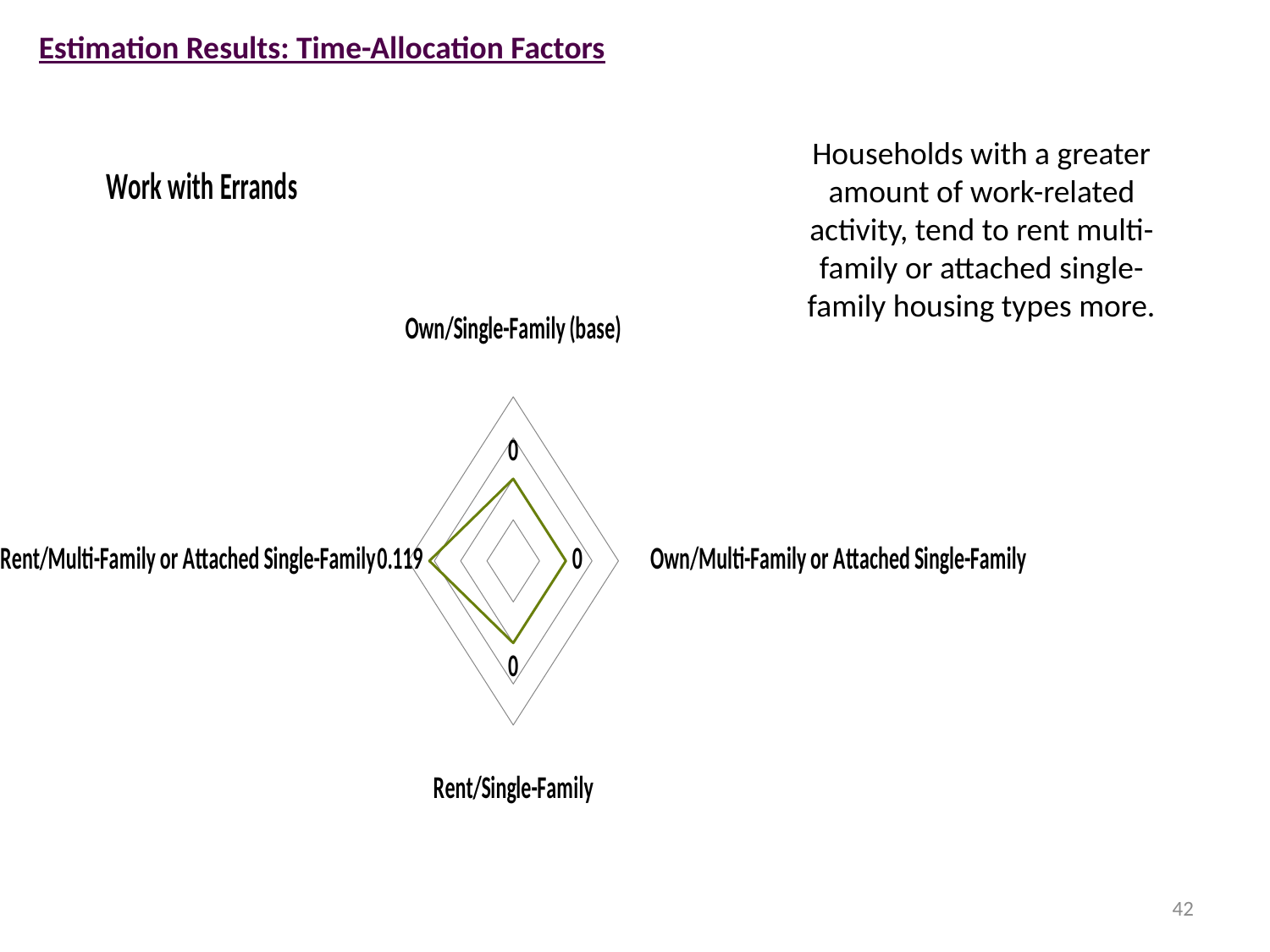
What is the title of the chart? Work with Errands What is the value for Rent/Single-Family? 0 How many categories have a value of 0? 3 How many categories does the radar chart have? 4 What kind of chart is shown on the slide? radar chart Which category has the highest value? Rent/Multi-Family or Attached Single-Family Which is larger, the value for Rent/Multi-Family or Attached Single-Family or the value for Own/Multi-Family or Attached Single-Family? Rent/Multi-Family or Attached Single-Family What is the value for Rent/Multi-Family or Attached Single-Family? 0.119 Which category is labelled as the base? Own/Single-Family (base) What is the difference between the values for Rent/Multi-Family or Attached Single-Family and Rent/Single-Family? 0.119 What is the value for Own/Single-Family (base)? 0 What is the value for Own/Multi-Family or Attached Single-Family? 0